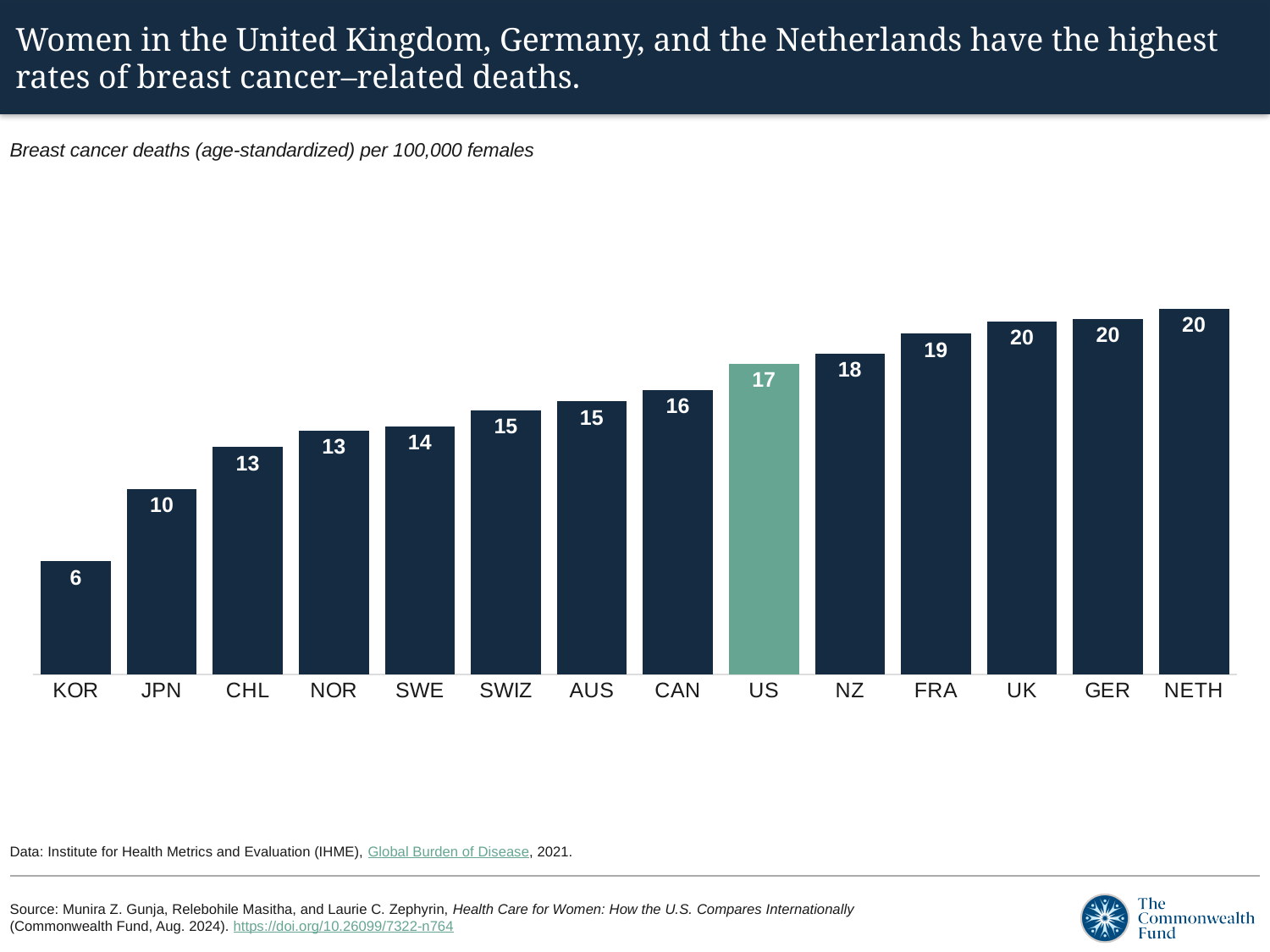
What is the value shown for FRA? 19 What is the difference between the values for NETH and KOR? 14 What is the breast cancer death rate per 100,000 females for the US? 17 Which has a higher value, NZ or SWE? NZ Which has a higher value, CHL or AUS? AUS Which country's bar is shown in a different colour (green) from the others? US What is the value shown for JPN? 10 Which country has the lowest breast cancer death rate on the chart? KOR How many countries are shown on the chart? 14 What is the difference between the values for US and CAN? 1 What kind of chart is shown on the slide? Bar chart Do the values rise or fall moving from left to right along the x axis? Rise